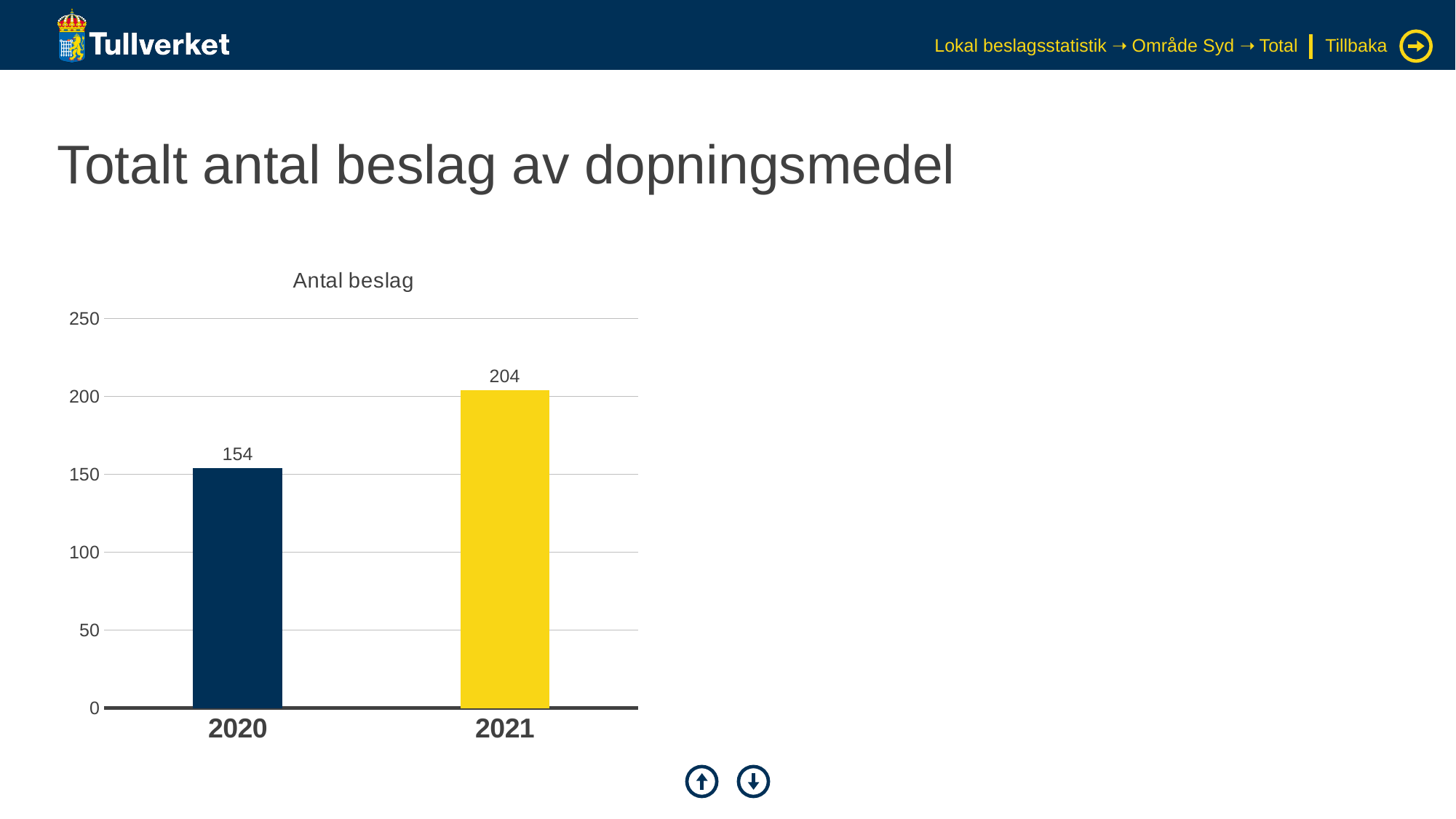
Is the value for 2020 greater or less than 150? greater Is the value for 2021 greater or less than 250? less What is the difference between the values for 2021 and 2020? 50 What is the value for 2021 in the Antal beslag chart? 204 Which year has the highest number of seizures? 2021 What is the value for 2020 in the Antal beslag chart? 154 What kind of chart is shown on the slide? bar chart How many years are shown on the x axis of the chart? 2 Do the values rise or fall from 2020 to 2021? rise What is the title of the chart? Antal beslag Which is larger, the value for 2020 or the value for 2021? 2021 Which year has the lowest number of seizures? 2020